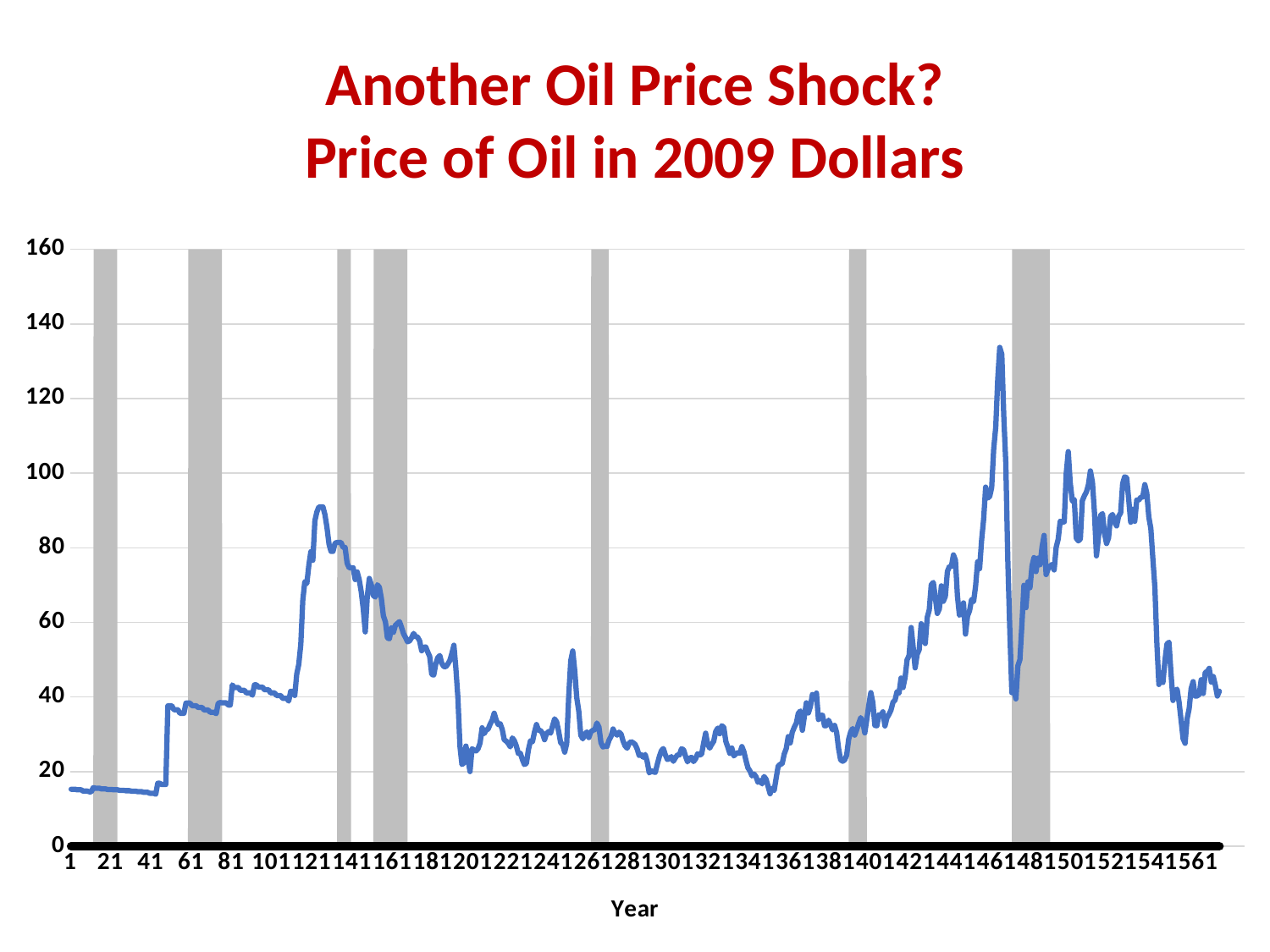
What is the label of the x axis? Year Does the line generally rise or fall between x = 341 and x = 461? rise Which is larger, the value at x = 121 or the value at x = 461? x = 461 Is the highest value reached by the line greater or less than 120? greater What is the title of the chart? Another Oil Price Shock? Price of Oil in 2009 Dollars Does the line generally rise or fall between x = 121 and x = 341? fall What kind of chart is shown on the slide? line chart Is the value at x = 561 greater or less than 60? less Is the value at x = 1 greater or less than 20? less